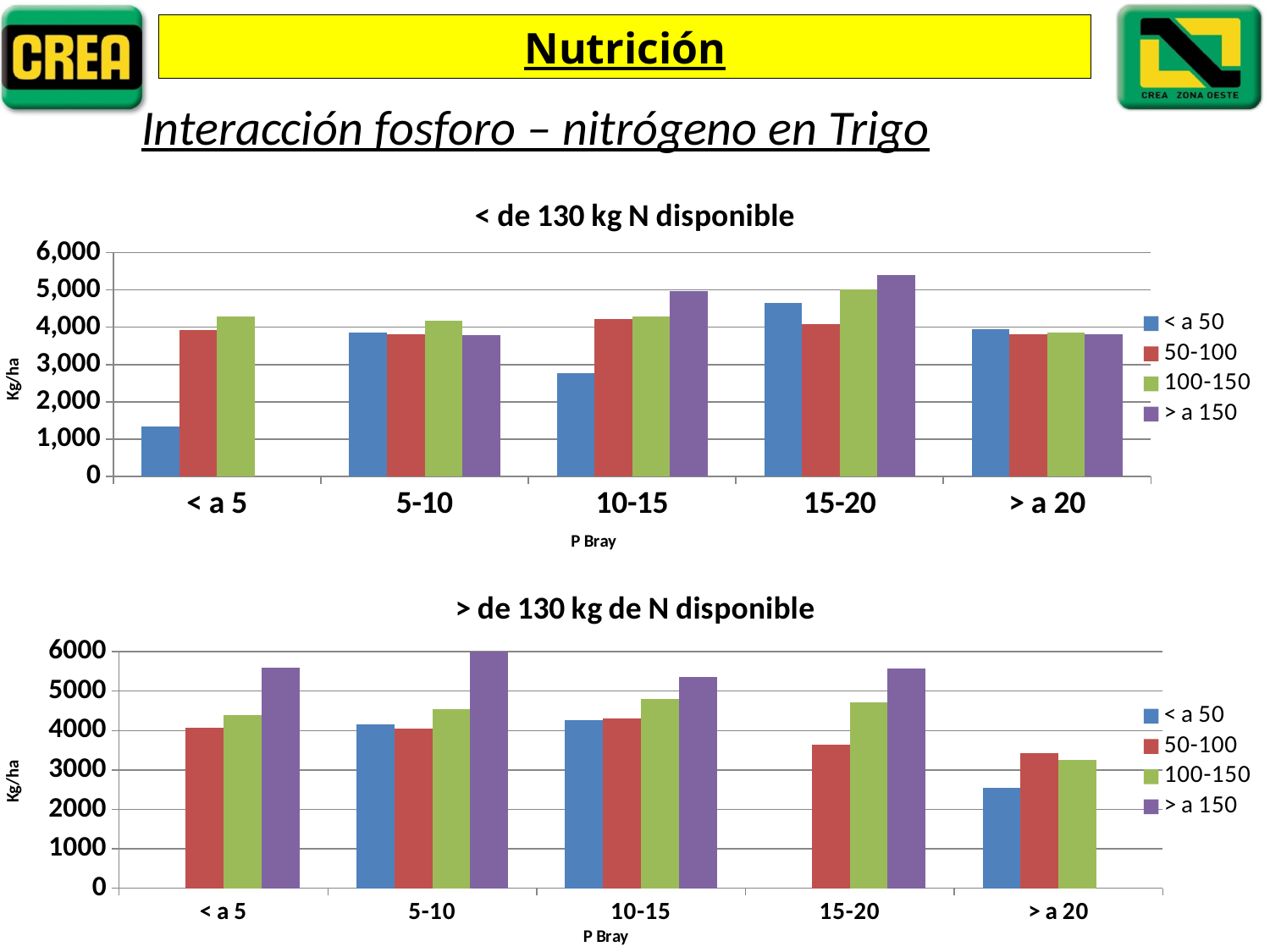
In the bottom chart titled "> de 130 kg de N disponible", is the value for "> a 150" at P Bray "5-10" greater or less than 5000? greater In the top chart titled "< de 130 kg N disponible", is the value for "< a 50" at P Bray "< a 5" greater or less than 2,000? less In the bottom chart titled "> de 130 kg de N disponible", at which P Bray category is the "< a 50" bar lowest? > a 20 In the top chart titled "< de 130 kg N disponible", how many P Bray categories are shown on the x axis? 5 In the bottom chart titled "> de 130 kg de N disponible", at P Bray "15-20", which is larger: "100-150" or "50-100"? 100-150 In the top chart titled "< de 130 kg N disponible", what kind of chart is shown? bar chart In the top chart titled "< de 130 kg N disponible", how many series does the legend list? 4 In the bottom chart titled "> de 130 kg de N disponible", is the value for "< a 50" at P Bray "> a 20" greater or less than 3000? less In the top chart titled "< de 130 kg N disponible", what is the label on the vertical axis? Kg/ha In the top chart titled "< de 130 kg N disponible", at which P Bray category is the "> a 150" bar highest? 15-20 What is the title of the bottom chart on the slide? > de 130 kg de N disponible In the top chart titled "< de 130 kg N disponible", at P Bray "10-15", which is larger: "< a 50" or "50-100"? 50-100